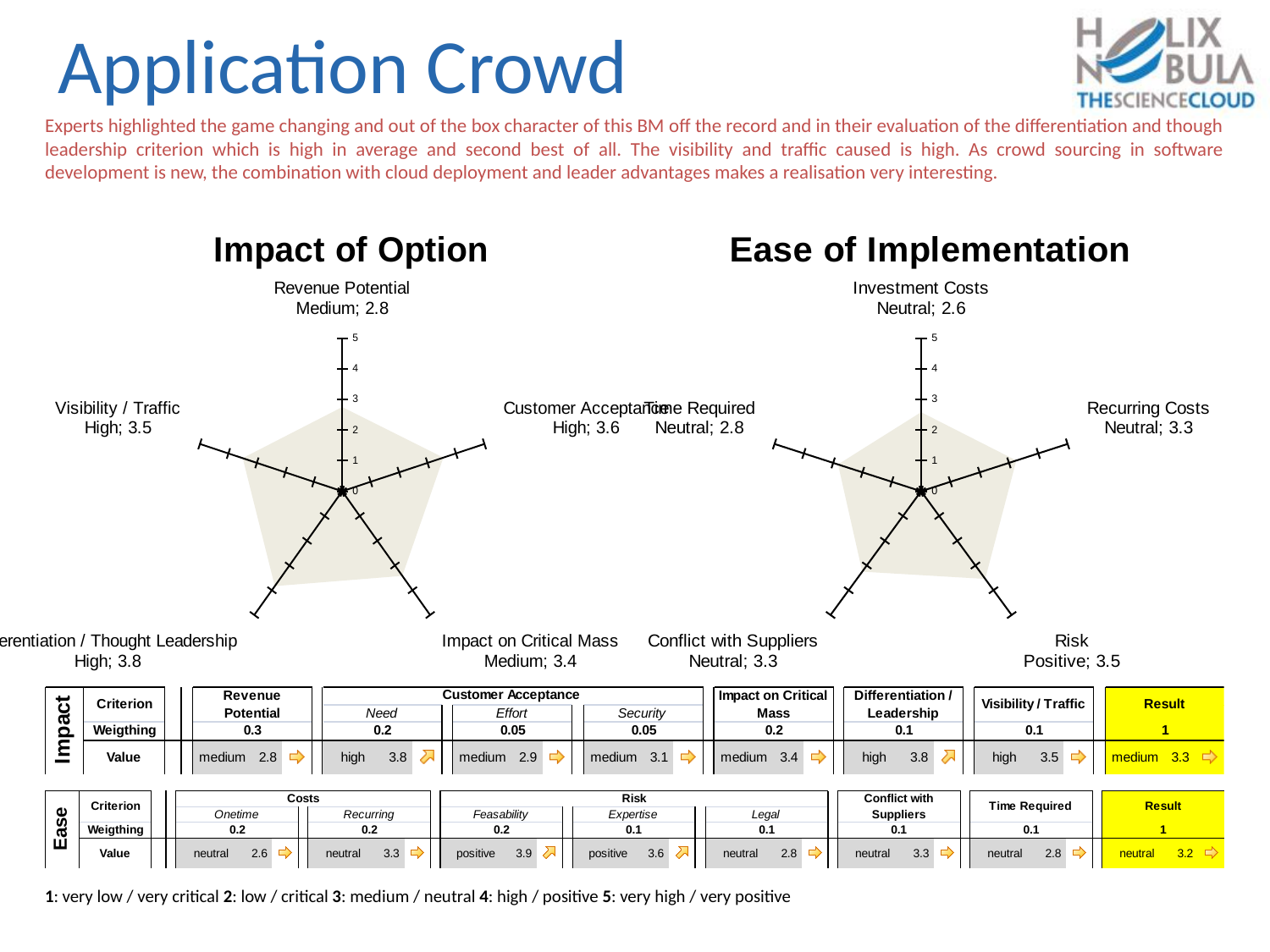
On the Impact of Option chart, what value is shown for Customer Acceptance? 3.6 On the Ease of Implementation chart, what rating and value are shown for Risk? Positive; 3.5 On the Impact of Option chart, which criterion has the lowest value? Revenue Potential On the Ease of Implementation chart, which criterion has the lowest value? Investment Costs On the Ease of Implementation chart, what is the difference between the Risk value and the Investment Costs value? 0.9 What type of chart is the Impact of Option chart? Radar chart On the Impact of Option chart, what value is shown for Revenue Potential? 2.8 On the Impact of Option chart, which criterion has the highest value? Differentiation / Thought Leadership On the Ease of Implementation chart, what value is shown for Investment Costs? 2.6 On the Ease of Implementation chart, is the value for Time Required greater or less than 3? less How many criteria (axes) does the Ease of Implementation chart have? 5 On the Impact of Option chart, which is larger: Visibility / Traffic or Impact on Critical Mass? Visibility / Traffic